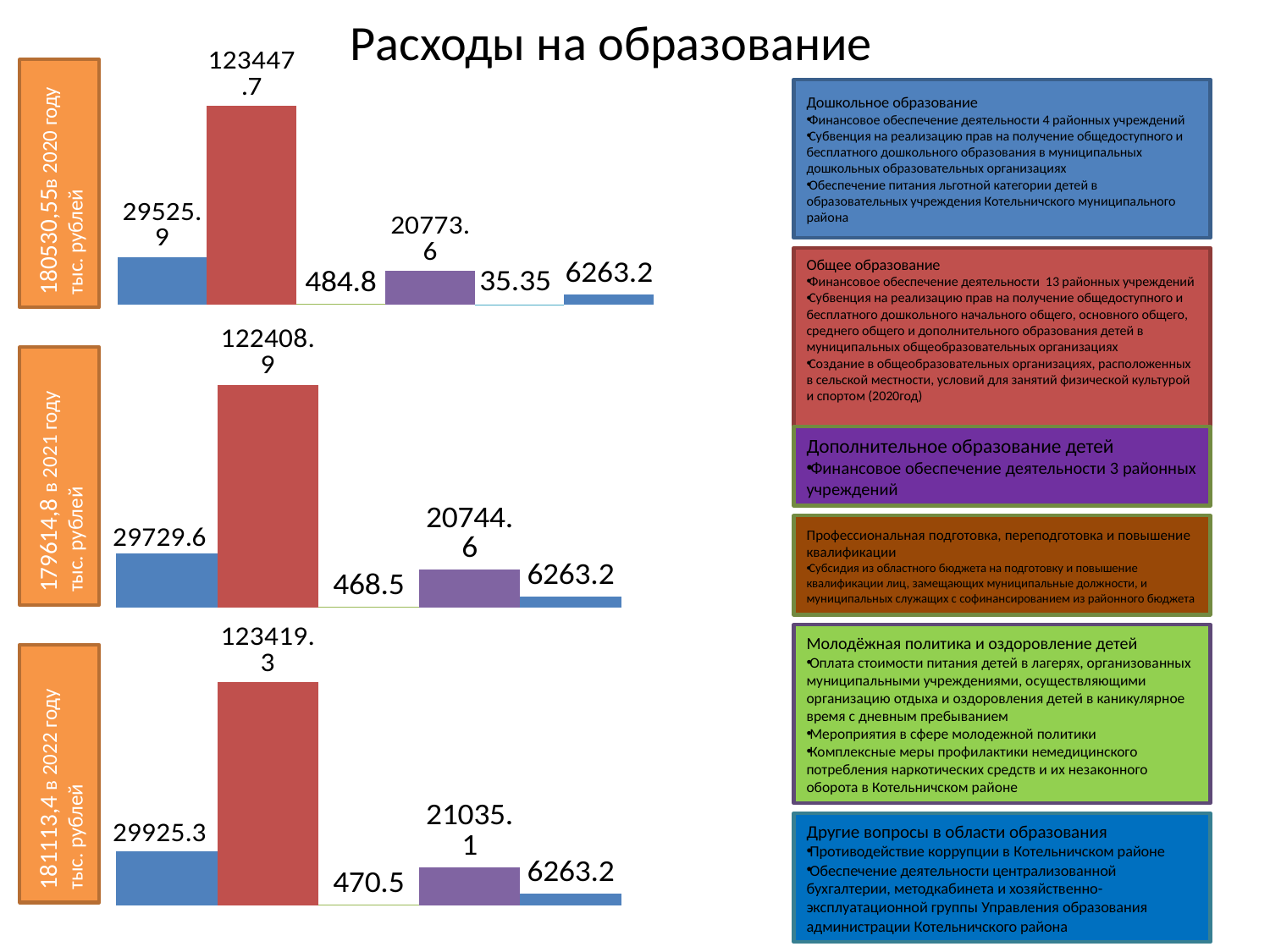
In the 2020 chart (180530,55 в 2020 году), what is the value of the tallest (red) bar? 123447.7 In the 2021 chart (179614,8 в 2021 году), what is the value of the purple bar? 20744.6 In the 2022 chart (181113,4 в 2022 году), what is the value of the red bar? 123419.3 In the 2020 chart (180530,55 в 2020 году), how many data values are labelled? 6 In the 2022 chart (181113,4 в 2022 году), what is the value of the last (rightmost) bar? 6263.2 In the 2021 chart (179614,8 в 2021 году), what is the smallest labelled value? 468.5 In the 2022 chart (181113,4 в 2022 году), which is larger: the first blue bar (29925.3) or the purple bar (21035.1)? the first blue bar (29925.3) In the 2021 chart (179614,8 в 2021 году), how many data values are labelled? 5 In the 2020 chart (180530,55 в 2020 году), what is the smallest labelled value? 35.35 In the 2020 chart (180530,55 в 2020 году), what is the difference between the red bar (123447.7) and the first blue bar (29525.9)? 93921.8 What type of chart is used for the 2020 education expenditure (180530,55 в 2020 году)? bar chart In the 2020 chart (180530,55 в 2020 году), what is the value of the first (blue) bar on the left? 29525.9